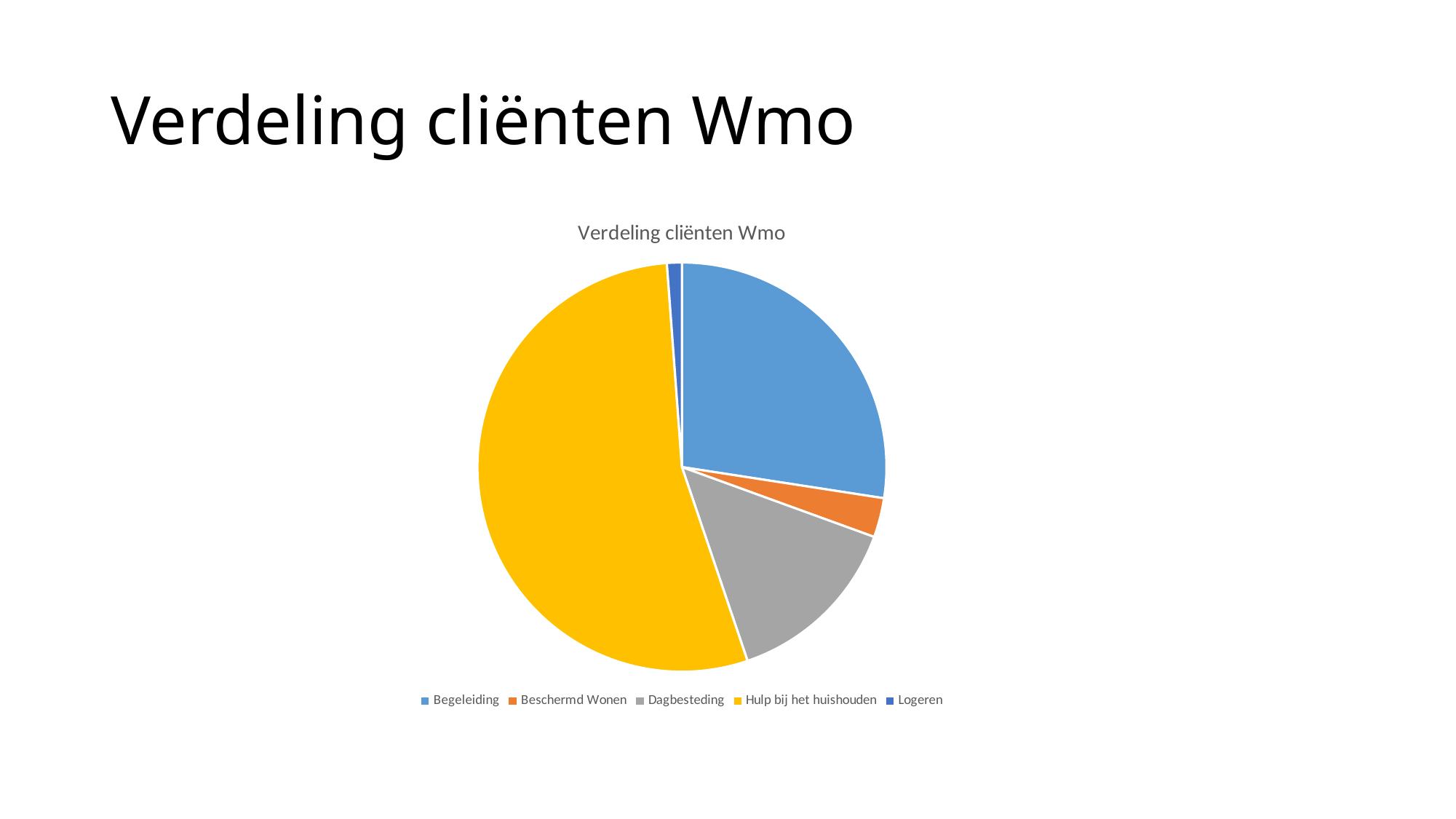
Is the share of Hulp bij het huishouden greater or less than half of the pie? greater Which category has the smallest slice of the pie? Logeren What is the title of the chart? Verdeling cliënten Wmo Which category has the largest slice of the pie? Hulp bij het huishouden Which slice is larger, Begeleiding or Dagbesteding? Begeleiding Which slice is larger, Dagbesteding or Beschermd Wonen? Dagbesteding How many entries does the legend list? 5 How many slices does the pie chart have? 5 What kind of chart is shown on the slide? pie chart What colour is the Hulp bij het huishouden slice? yellow Which slice is larger, Beschermd Wonen or Logeren? Beschermd Wonen